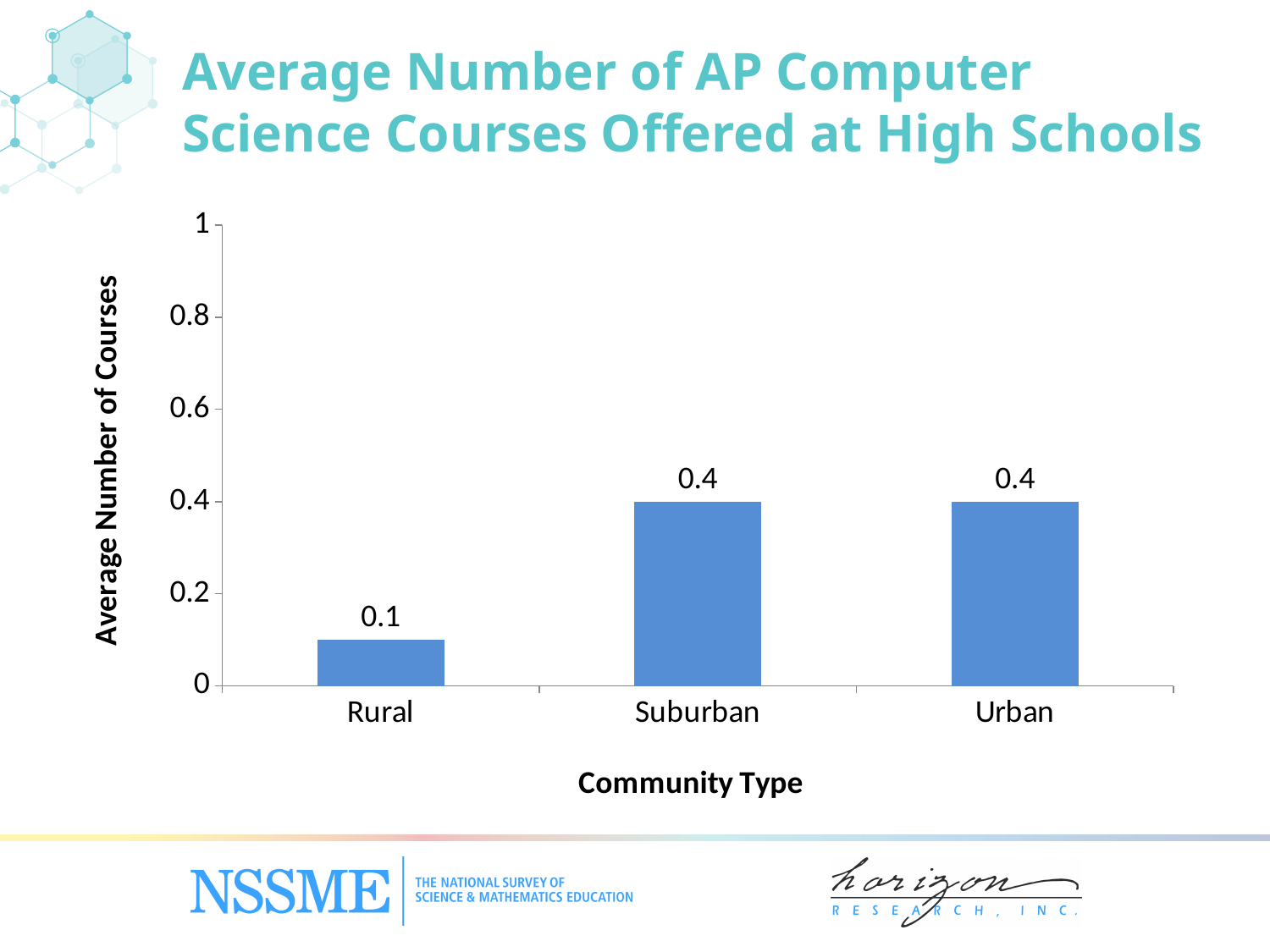
What is the average number of AP Computer Science courses offered at suburban high schools? 0.4 What is the average number of AP Computer Science courses offered at rural high schools? 0.1 Which is larger, the value for Rural or the value for Urban? Urban How many community types are shown on the x axis? 3 Is the value for Suburban greater or less than 0.6? less What is the label of the y axis? Average Number of Courses What is the label of the x axis? Community Type What is the difference between the average number of courses for Suburban and Rural schools? 0.3 What is the average number of AP Computer Science courses offered at urban high schools? 0.4 Which community type has the lowest average number of AP Computer Science courses? Rural Is the value for Rural greater or less than 0.2? less What kind of chart is shown on the slide? Bar chart